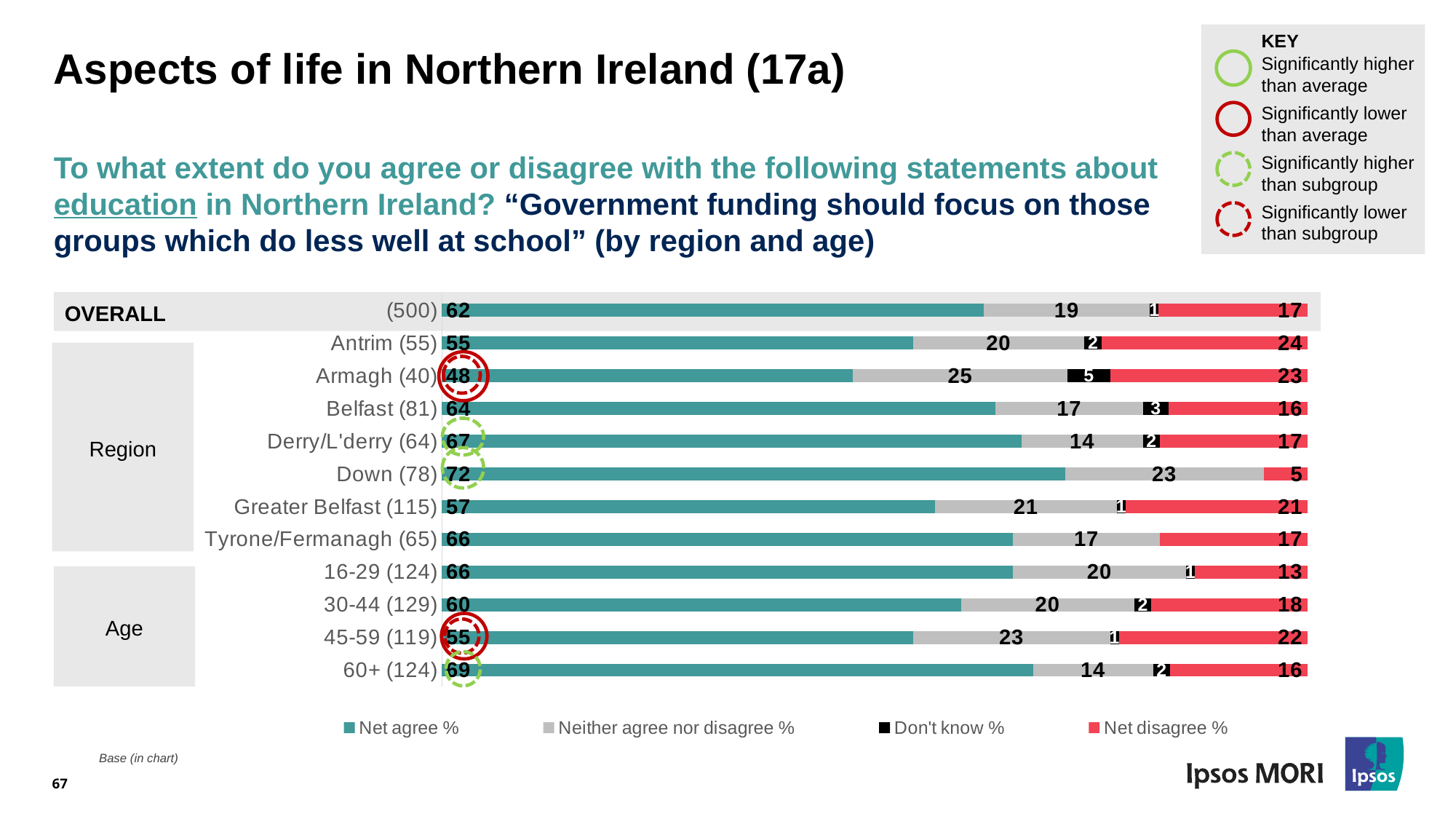
Which has a higher Net agree %, Derry/L'derry (64) or Greater Belfast (115)? Derry/L'derry (64) What is the difference in Net agree % between 60+ (124) and 45-59 (119)? 14 How many categories (bars) are shown in the chart? 12 What is the Net agree % for Down (78)? 72 Which category has the lowest Net agree %? Armagh (40) What is the Neither agree nor disagree % for Armagh (40)? 25 What is the Don't know % for Belfast (81)? 3 Which category has the highest Net agree %? Down (78) Which category has the lowest Net disagree %? Down (78) What kind of chart is shown on the slide? Stacked bar chart How many series does the legend list? 4 What is the Net disagree % for Antrim (55)? 24